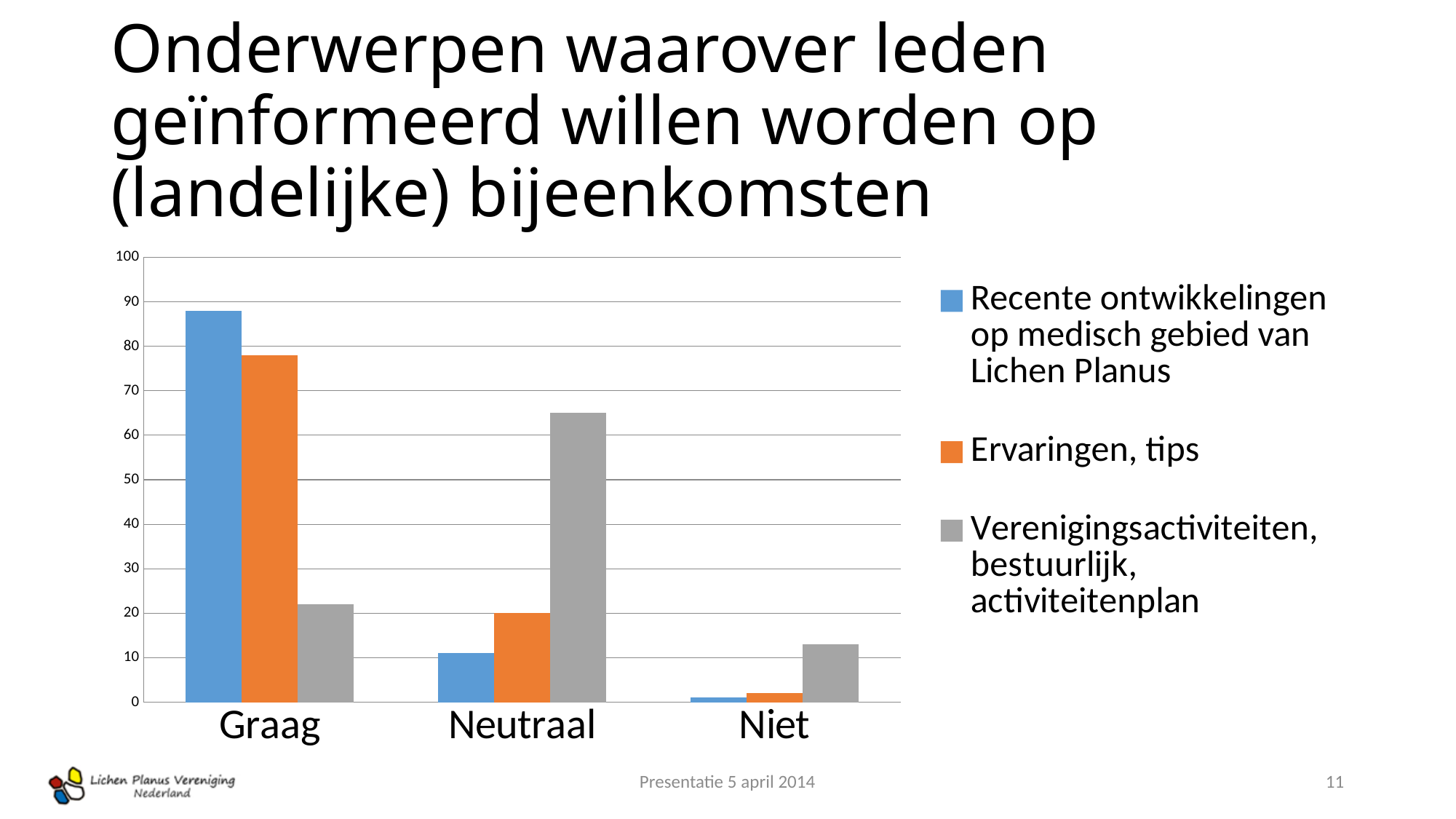
Is the value for 'Verenigingsactiviteiten, bestuurlijk, activiteitenplan' in the Neutraal category greater or less than 60? greater Which category has the highest value for the series 'Recente ontwikkelingen op medisch gebied van Lichen Planus'? Graag What kind of chart is shown on the slide? bar chart Is the value for 'Recente ontwikkelingen op medisch gebied van Lichen Planus' in the Graag category greater or less than 80? greater Which category has the lowest value for the series 'Ervaringen, tips'? Niet How many series does the legend list? 3 Is the value for 'Verenigingsactiviteiten, bestuurlijk, activiteitenplan' in the Graag category greater or less than 30? less In the Graag category, which is larger: 'Recente ontwikkelingen op medisch gebied van Lichen Planus' or 'Ervaringen, tips'? Recente ontwikkelingen op medisch gebied van Lichen Planus How many categories are shown on the x axis? 3 Which category has the highest value for the series 'Verenigingsactiviteiten, bestuurlijk, activiteitenplan'? Neutraal In the Niet category, which is larger: 'Ervaringen, tips' or 'Verenigingsactiviteiten, bestuurlijk, activiteitenplan'? Verenigingsactiviteiten, bestuurlijk, activiteitenplan Which colour represents the series 'Ervaringen, tips' in the legend? orange